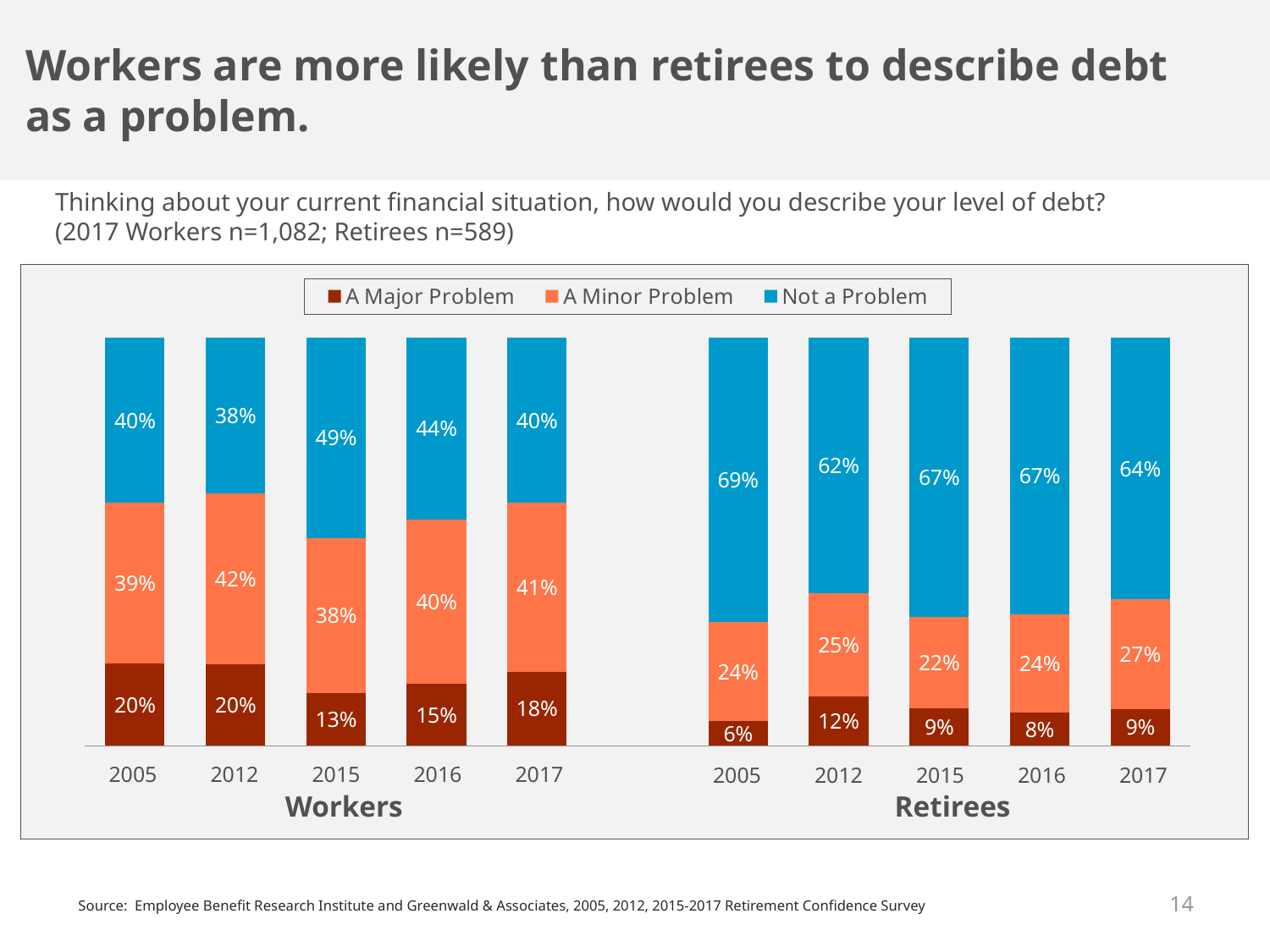
Among the Workers bars, which year has the highest share saying debt is not a problem? 2015 What percentage of Retirees in 2005 said debt was not a problem? 69% What kind of chart is shown on the slide? Stacked bar chart Among the Retirees bars, which year has the lowest share saying debt is a major problem? 2005 What percentage of Retirees in 2017 described debt as a minor problem? 27% What is the total of the three segments in the Workers 2015 bar? 100% In 2016, which group had a larger share saying debt is not a problem, Workers or Retirees? Retirees What is the difference between the share of Workers and the share of Retirees who called debt a major problem in 2017? 9 percentage points Which legend entry is shown in blue? Not a Problem What percentage of Workers in 2017 described debt as a major problem? 18% How many years are shown for each group on the chart? 5 How many series does the legend list? 3